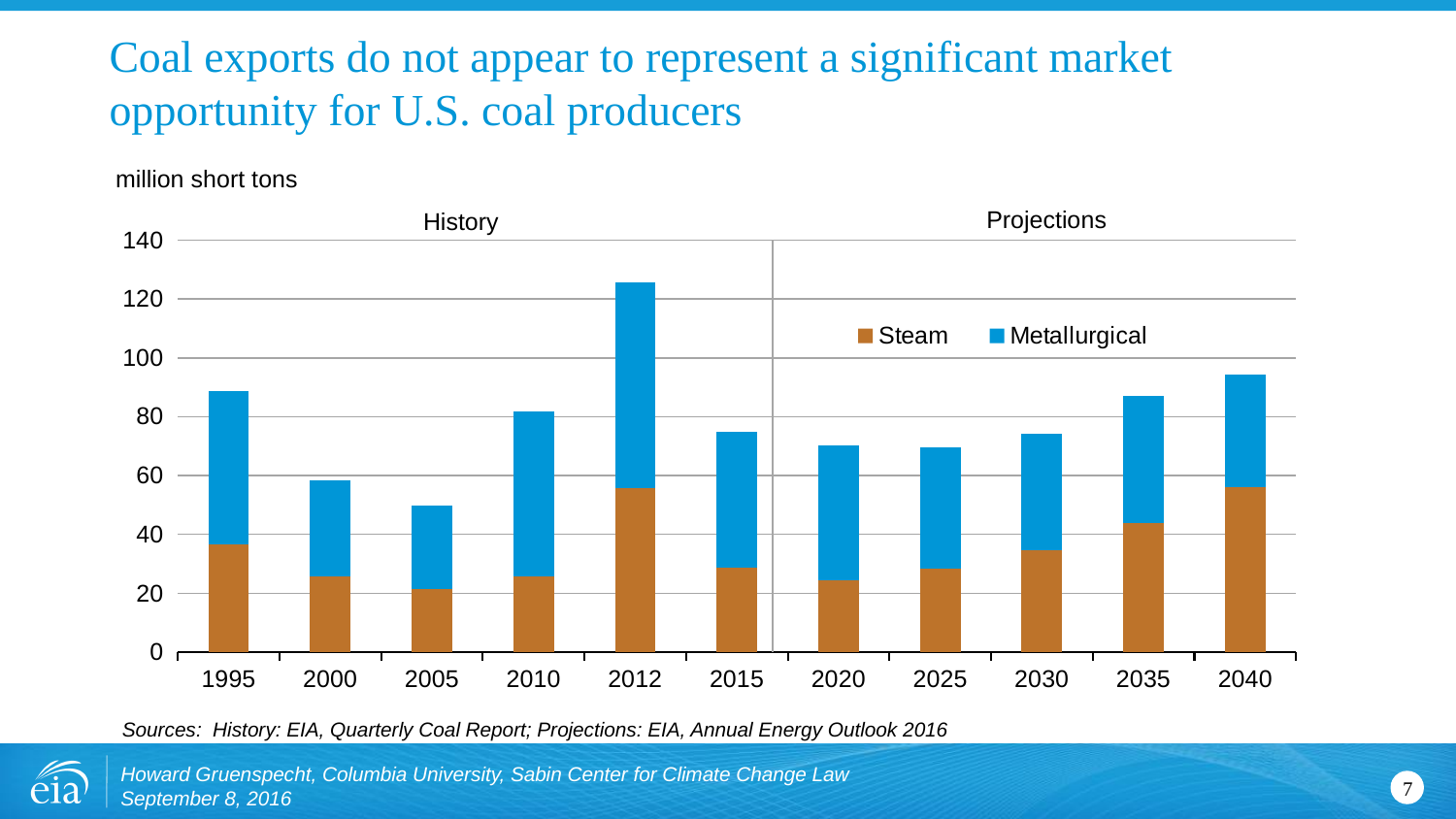
What unit is given for the y axis? million short tons What kind of chart is shown on the slide? Stacked bar chart Which year has the highest total coal exports? 2012 How many years are shown on the x axis? 11 Is the Steam value for 2040 greater or less than 40? greater Is the total value for 2040 greater or less than 100? less Is the total value for 2005 greater or less than 60? less Which year has the larger total, 2012 or 2015? 2012 Which year has the lowest total coal exports? 2005 How many series does the legend list? 2 Do total coal exports rise or fall across the projection years from 2020 to 2040? Rise